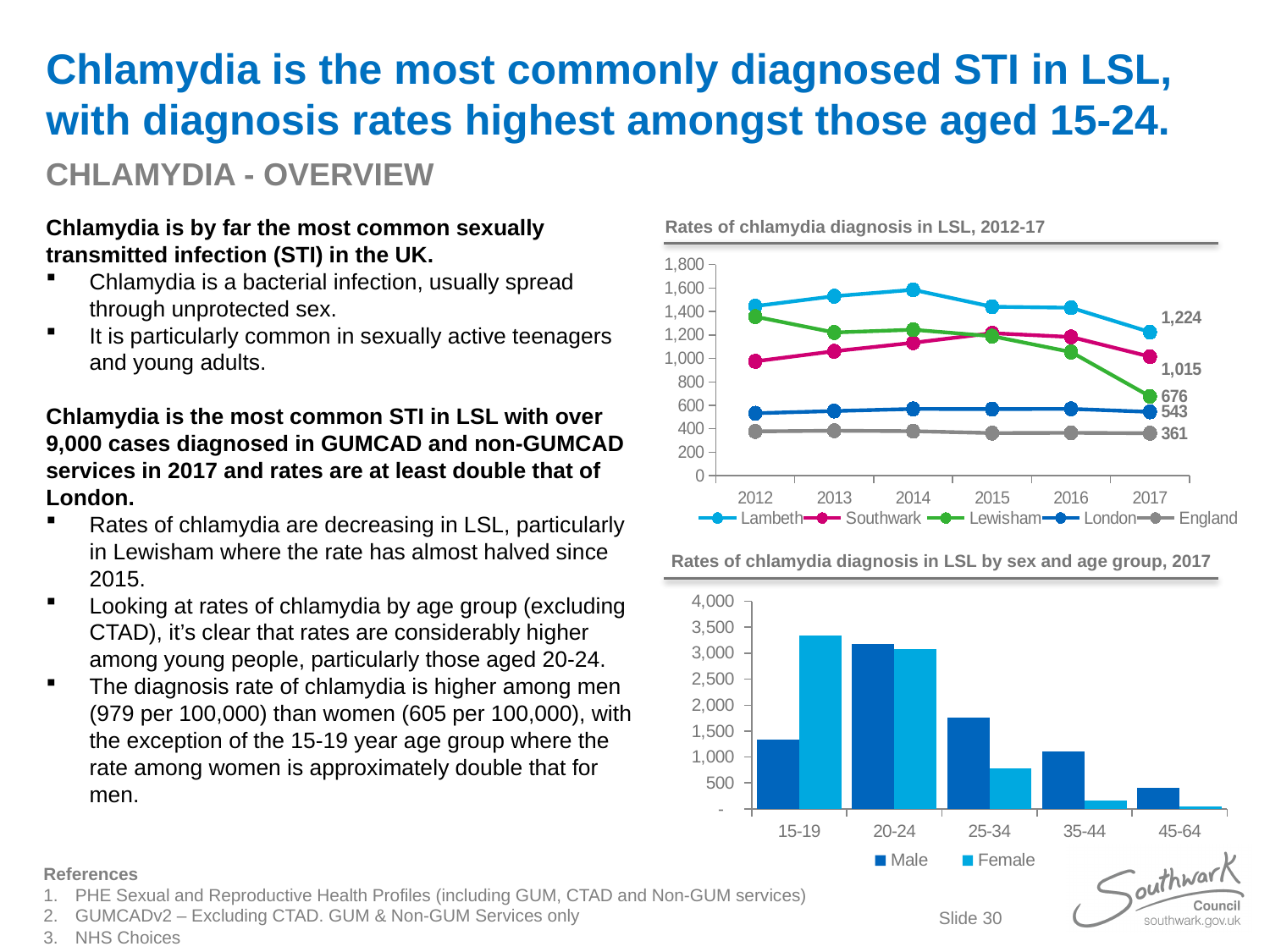
In the chart 'Rates of chlamydia diagnosis in LSL, 2012-17', what is the value for England in 2017? 361 In the chart 'Rates of chlamydia diagnosis in LSL, 2012-17', is the Lambeth value in 2014 greater or less than 1,400? greater What kind of chart is 'Rates of chlamydia diagnosis in LSL by sex and age group, 2017'? bar chart In the chart 'Rates of chlamydia diagnosis in LSL, 2012-17', what is the difference between the Southwark and London values in 2017? 472 In the chart 'Rates of chlamydia diagnosis in LSL, 2012-17', what is the value for Lambeth in 2017? 1,224 In the chart 'Rates of chlamydia diagnosis in LSL by sex and age group, 2017', is the Female value for 15-19 greater or less than 3,000? greater In the chart 'Rates of chlamydia diagnosis in LSL by sex and age group, 2017', how many age groups are shown on the x axis? 5 In the chart 'Rates of chlamydia diagnosis in LSL by sex and age group, 2017', which age group has the highest Male value? 20-24 In the chart 'Rates of chlamydia diagnosis in LSL, 2012-17', how many series does the legend list? 5 In the chart 'Rates of chlamydia diagnosis in LSL, 2012-17', what is the value for Lewisham in 2017? 676 In the chart 'Rates of chlamydia diagnosis in LSL, 2012-17', does the Lewisham line rise or fall between 2015 and 2017? fall In the chart 'Rates of chlamydia diagnosis in LSL, 2012-17', which area has the highest rate in 2017? Lambeth